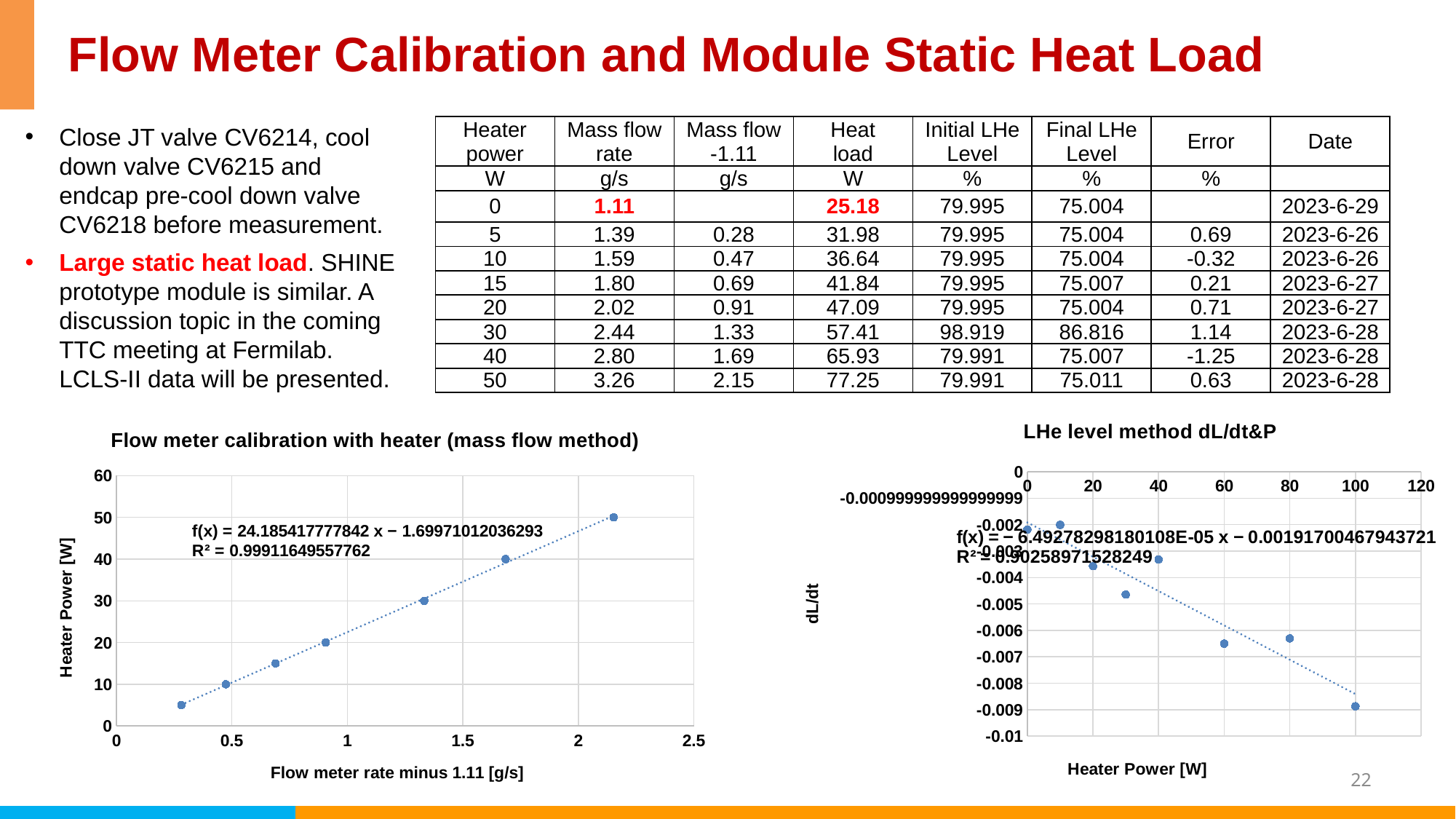
In the right chart 'LHe level method dL/dt&P', is the dL/dt value at 100 W greater or less than -0.008? less In the left chart 'Flow meter calibration with heater (mass flow method)', does heater power rise or fall as the flow meter rate increases? rise In the left chart 'Flow meter calibration with heater (mass flow method)', what is the label of the x axis? Flow meter rate minus 1.11 [g/s] In the right chart 'LHe level method dL/dt&P', at which heater power is dL/dt lowest? 100 In the left chart 'Flow meter calibration with heater (mass flow method)', how many data points are plotted? 7 In the left chart 'Flow meter calibration with heater (mass flow method)', what is the R² value shown for the trend line? 0.99911649557762 What kind of chart is the left chart titled 'Flow meter calibration with heater (mass flow method)'? scatter chart What kind of chart is the right chart titled 'LHe level method dL/dt&P'? scatter chart In the left chart 'Flow meter calibration with heater (mass flow method)', is the heater power of the leftmost point greater or less than 10? less In the right chart 'LHe level method dL/dt&P', how many data points are plotted? 8 In the right chart 'LHe level method dL/dt&P', does dL/dt rise or fall as heater power increases? fall In the left chart 'Flow meter calibration with heater (mass flow method)', is the heater power of the rightmost point greater or less than 40? greater